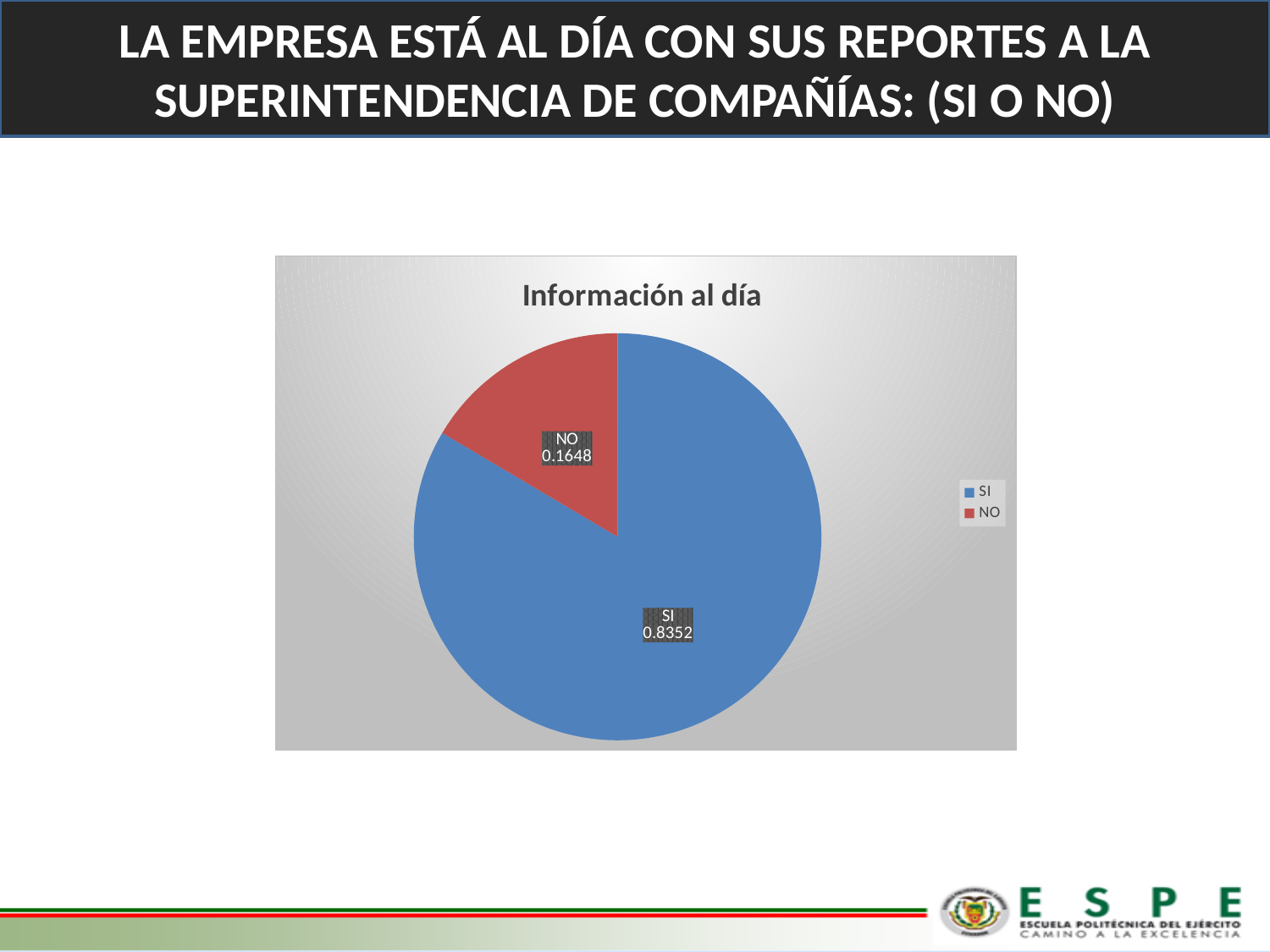
What is the title of the chart? Información al día Which slice is the smallest? NO What is the total of the SI and NO values? 1 How many slices does the pie chart have? 2 What value is shown for the NO slice? 0.1648 What colour is the SI slice? blue What is the difference between the SI value and the NO value? 0.6704 What value is shown for the SI slice? 0.8352 Which slice is the largest? SI What type of chart is shown on the slide? pie chart Which is larger, the SI slice or the NO slice? SI How many entries does the legend list? 2